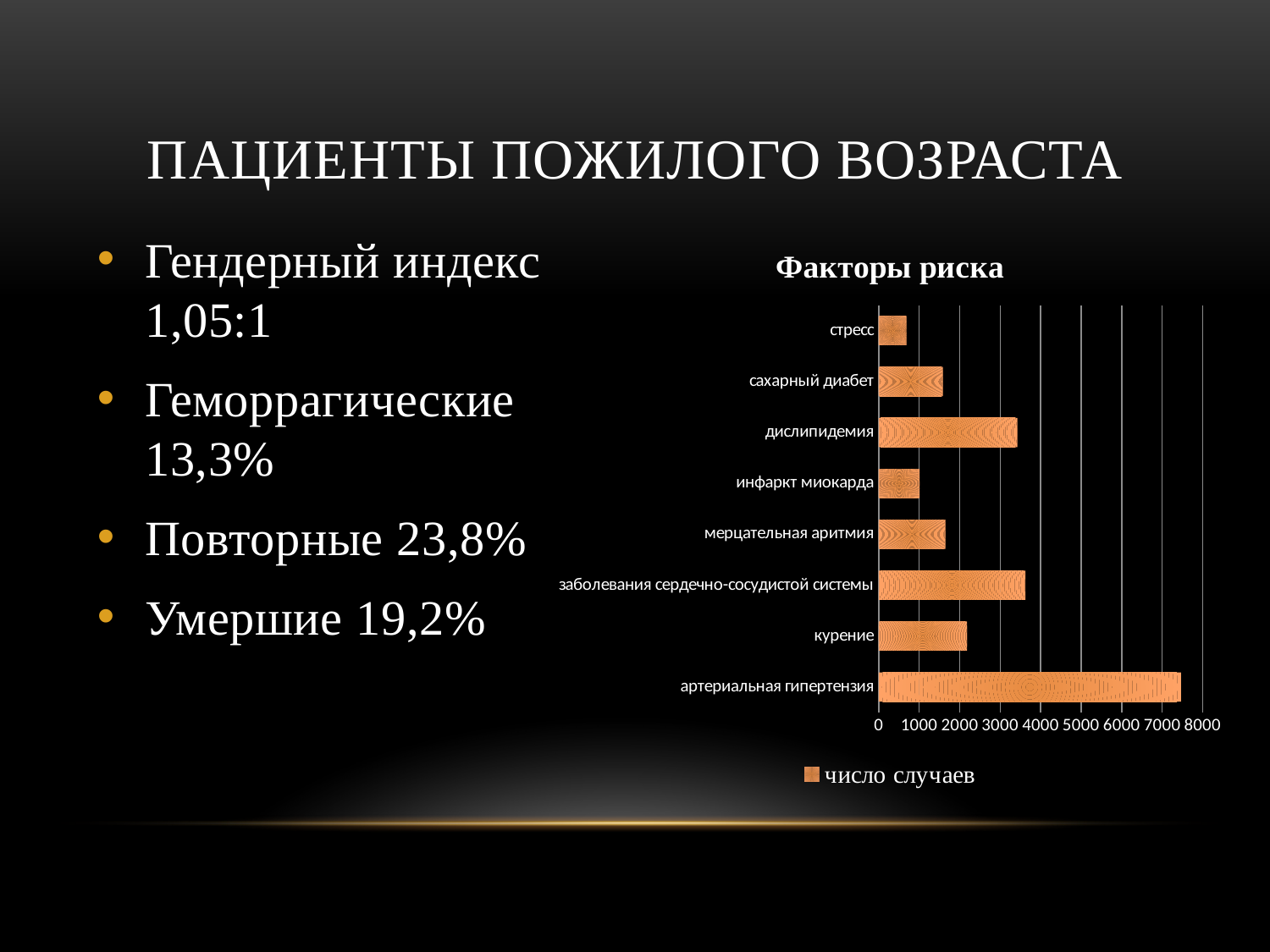
Which category has the lowest value in the "Факторы риска" chart? стресс Which is larger in the "Факторы риска" chart: инфаркт миокарда or мерцательная аритмия? мерцательная аритмия Is the value for стресс greater or less than 1000? less Is the value for курение greater or less than 2000? greater Is the value for дислипидемия greater or less than 3000? greater Which is larger in the "Факторы риска" chart: курение or сахарный диабет? курение How many series does the legend of the "Факторы риска" chart list? 1 Which category has the highest value in the "Факторы риска" chart? артериальная гипертензия How many categories are plotted in the "Факторы риска" chart? 8 What is the legend entry of the "Факторы риска" chart? число случаев What kind of chart is shown under the title "Факторы риска"? bar chart